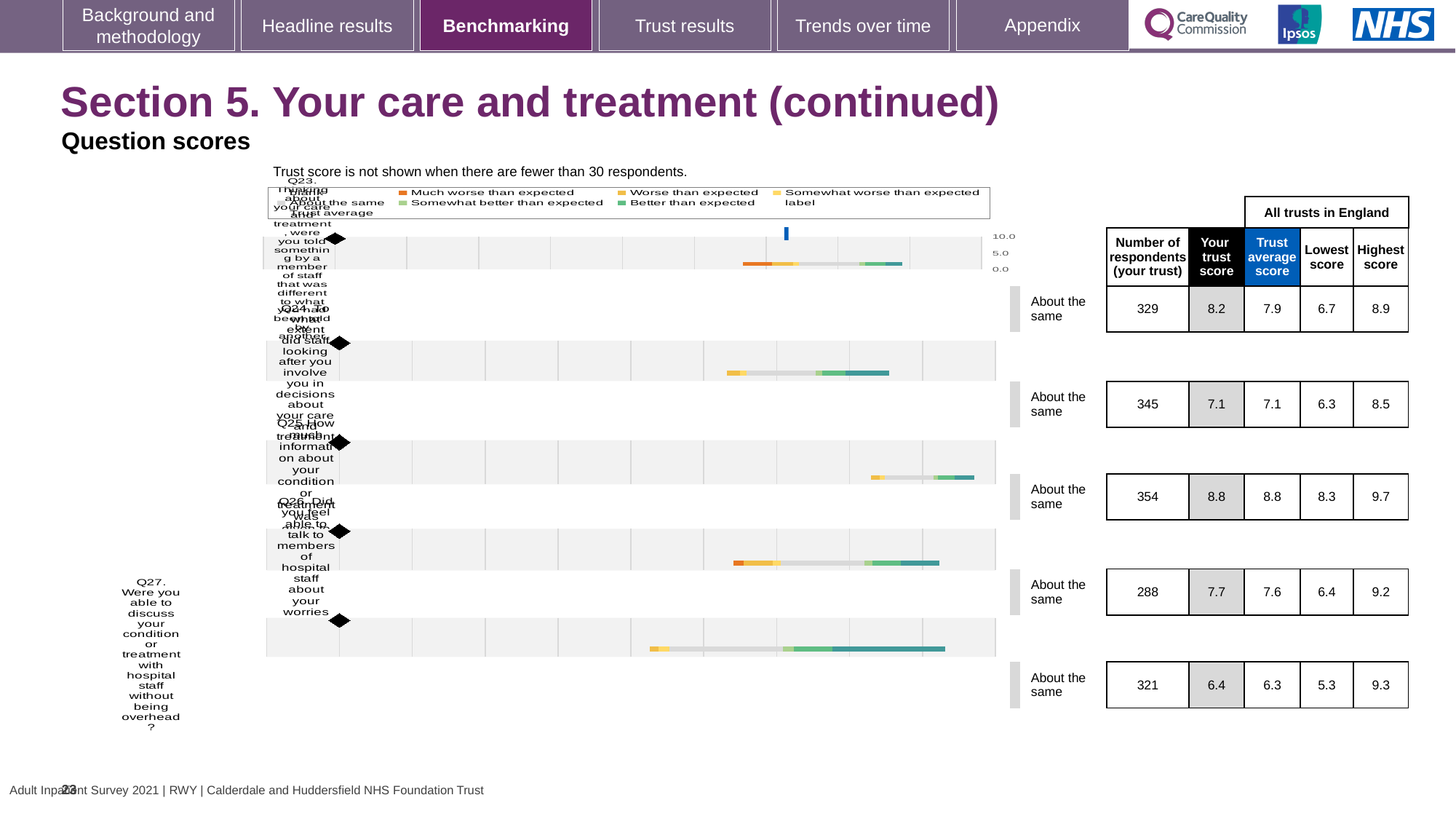
What benchmark category is shown next to each question's bar? About the same What kind of chart is used to show the question scores? Bar chart Which question has the lowest 'Your trust score'? Q27 Which question has the highest 'Your trust score'? Q25 How many respondents does the table show for Q24 (your trust)? 345 How many questions are plotted in the chart? 5 What is the lowest score across all trusts in England for Q26? 6.4 What is the 'Your trust score' for Q23? 8.2 What is the trust average score for Q27? 6.3 Which is larger, the 'Your trust score' for Q24 or for Q26? Q26 What is the highest score across all trusts in England for Q25? 9.7 What is the difference between the 'Your trust score' and the trust average score for Q23? 0.3